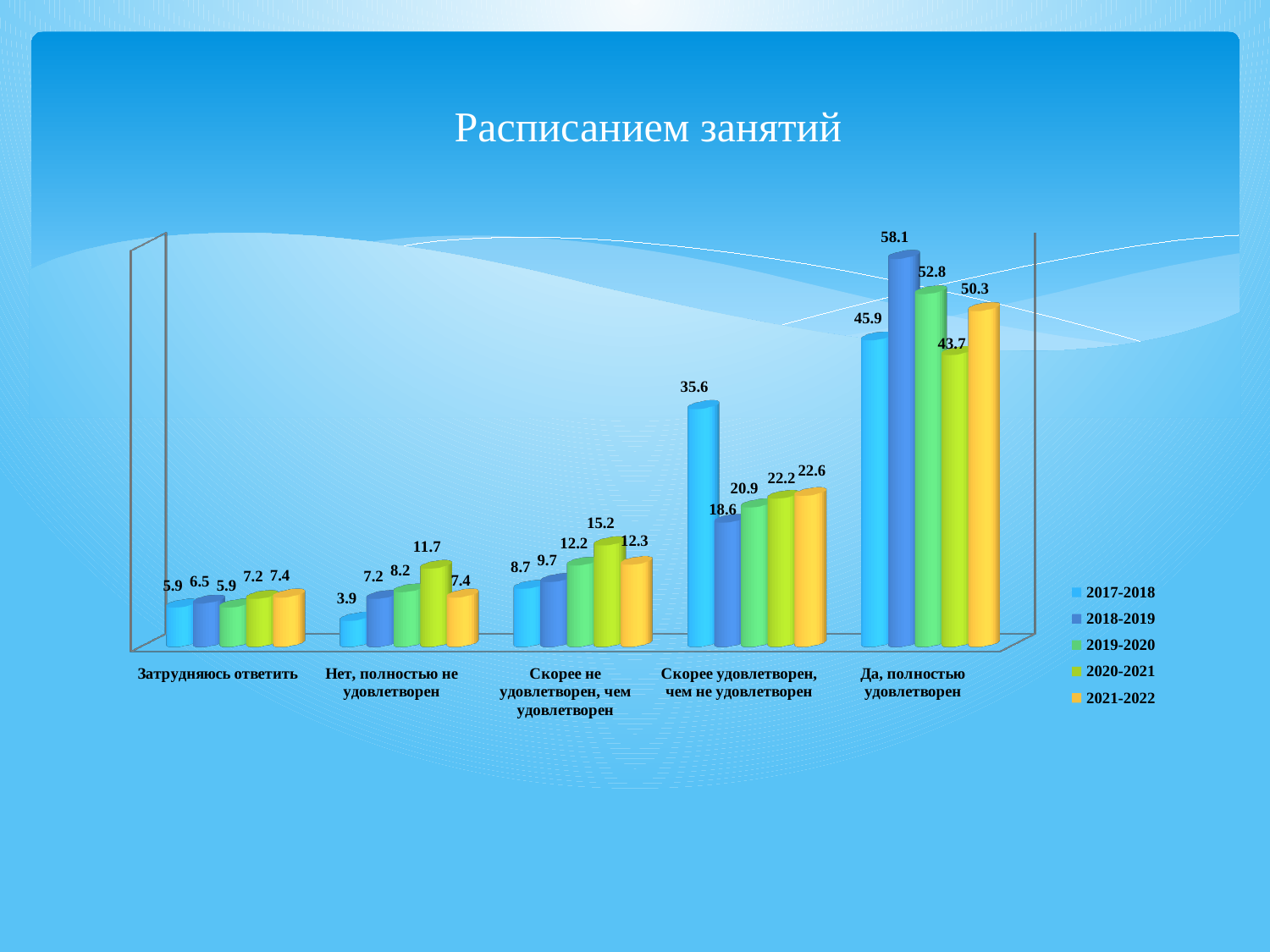
Which series has the highest value in the category "Да, полностью удовлетворен"? 2018-2019 What is the title of the slide? Расписанием занятий Which series has the lowest value in the category "Нет, полностью не удовлетворен"? 2017-2018 What is the value for 2018-2019 in the category "Да, полностью удовлетворен"? 58.1 How many series does the legend list? 5 What kind of chart is shown on the slide? Bar chart What is the value for 2020-2021 in the category "Нет, полностью не удовлетворен"? 11.7 In the category "Скорее удовлетворен, чем не удовлетворен", which is larger: the 2017-2018 value or the 2021-2022 value? 2017-2018 What is the value for 2017-2018 in the category "Скорее удовлетворен, чем не удовлетворен"? 35.6 What is the difference between the 2018-2019 and 2017-2018 values in the category "Да, полностью удовлетворен"? 12.2 How many categories are shown on the x axis? 5 What is the value for 2021-2022 in the category "Скорее не удовлетворен, чем удовлетворен"? 12.3